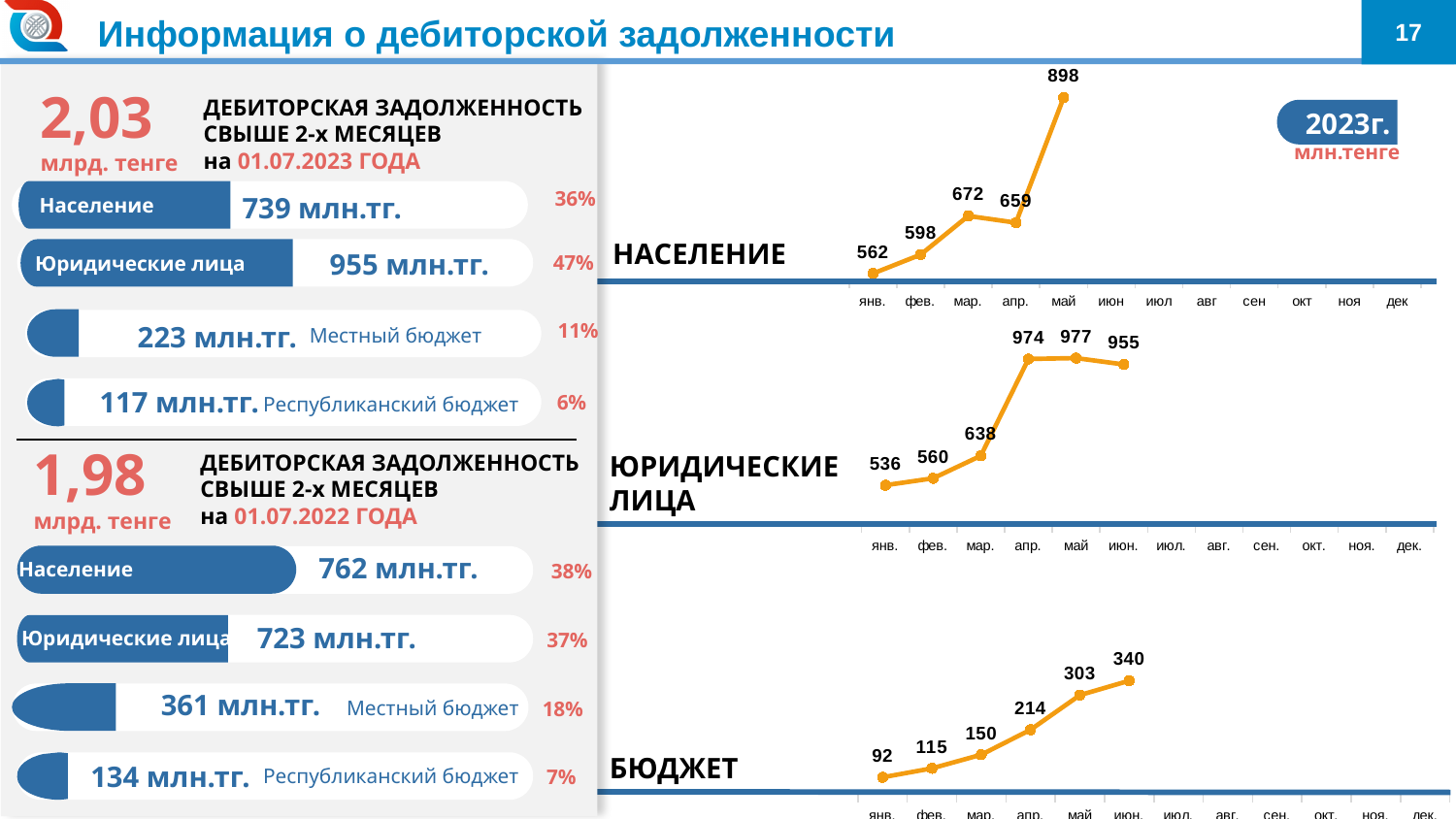
On the НАСЕЛЕНИЕ chart, what is the value for май? 898 On the ЮРИДИЧЕСКИЕ ЛИЦА chart, how many data points are plotted? 6 On the БЮДЖЕТ chart, what is the value for июн.? 340 On the ЮРИДИЧЕСКИЕ ЛИЦА chart, what is the value for апр.? 974 On the НАСЕЛЕНИЕ chart, what is the difference between the values for мар. and апр.? 13 On the НАСЕЛЕНИЕ chart, what is the value for янв.? 562 On the ЮРИДИЧЕСКИЕ ЛИЦА chart, which month has the lowest value? янв. On the БЮДЖЕТ chart, do the values rise or fall from янв. to июн.? rise On the БЮДЖЕТ chart, which is larger, the value for апр. or the value for мар.? апр. What type of chart is the БЮДЖЕТ chart? line chart On the НАСЕЛЕНИЕ chart, which month has the highest value? май On the ЮРИДИЧЕСКИЕ ЛИЦА chart, what is the difference between the values for мар. and фев.? 78